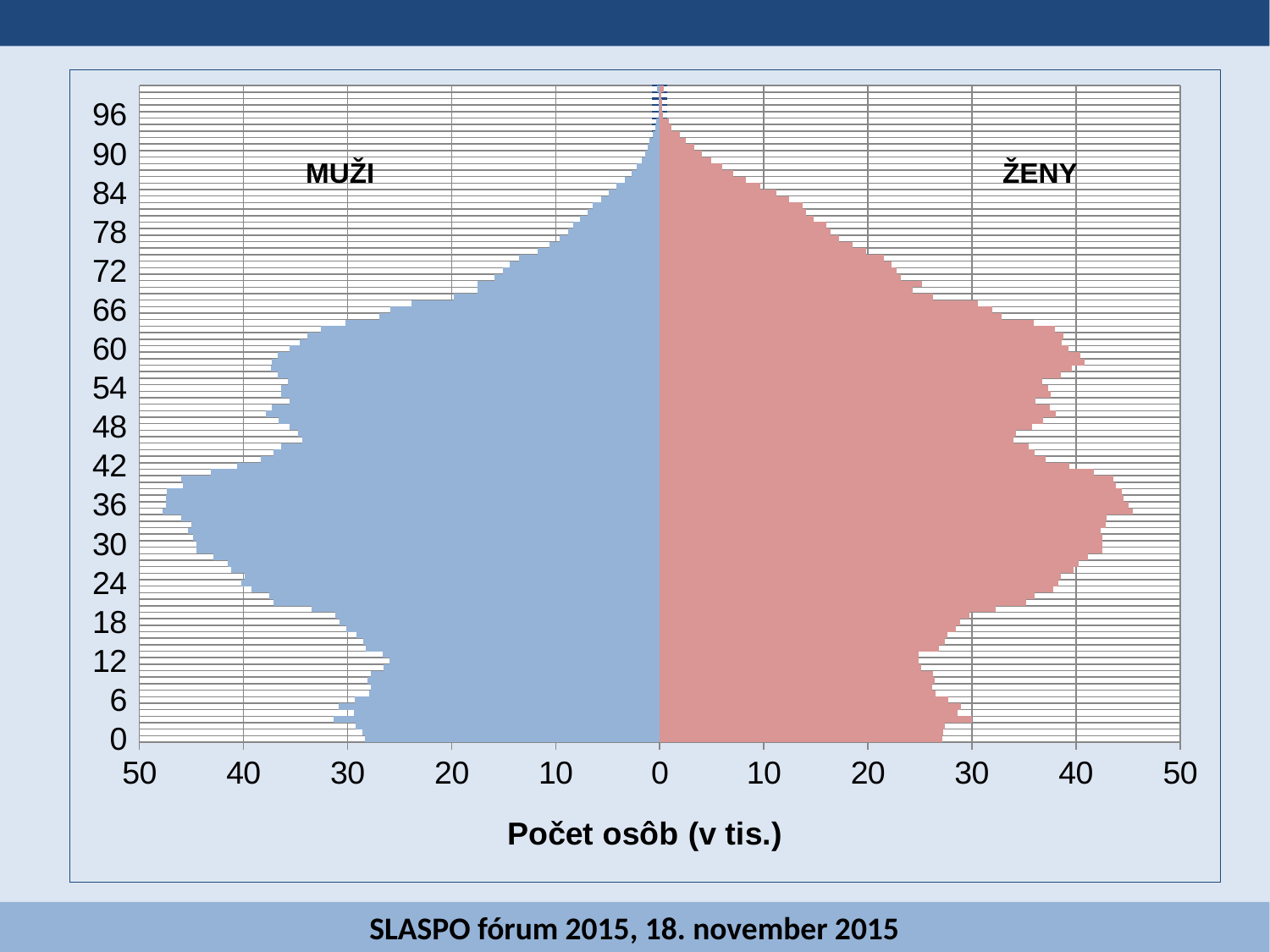
What is the title of the horizontal axis? Počet osôb (v tis.) Is the value for MUŽI at age 0 greater or less than 30? less Is the value for ŽENY at age 60 greater or less than 30? greater Is the value for ŽENY at age 36 greater or less than 40? greater At age 78, which group has the larger value, MUŽI or ŽENY? ŽENY Which two groups are labelled on the chart? MUŽI and ŽENY How many population groups (series) are plotted on the chart? 2 Do the values for MUŽI rise or fall as age increases from 36 to 96? fall What kind of chart is shown on the slide? bar chart (population pyramid)